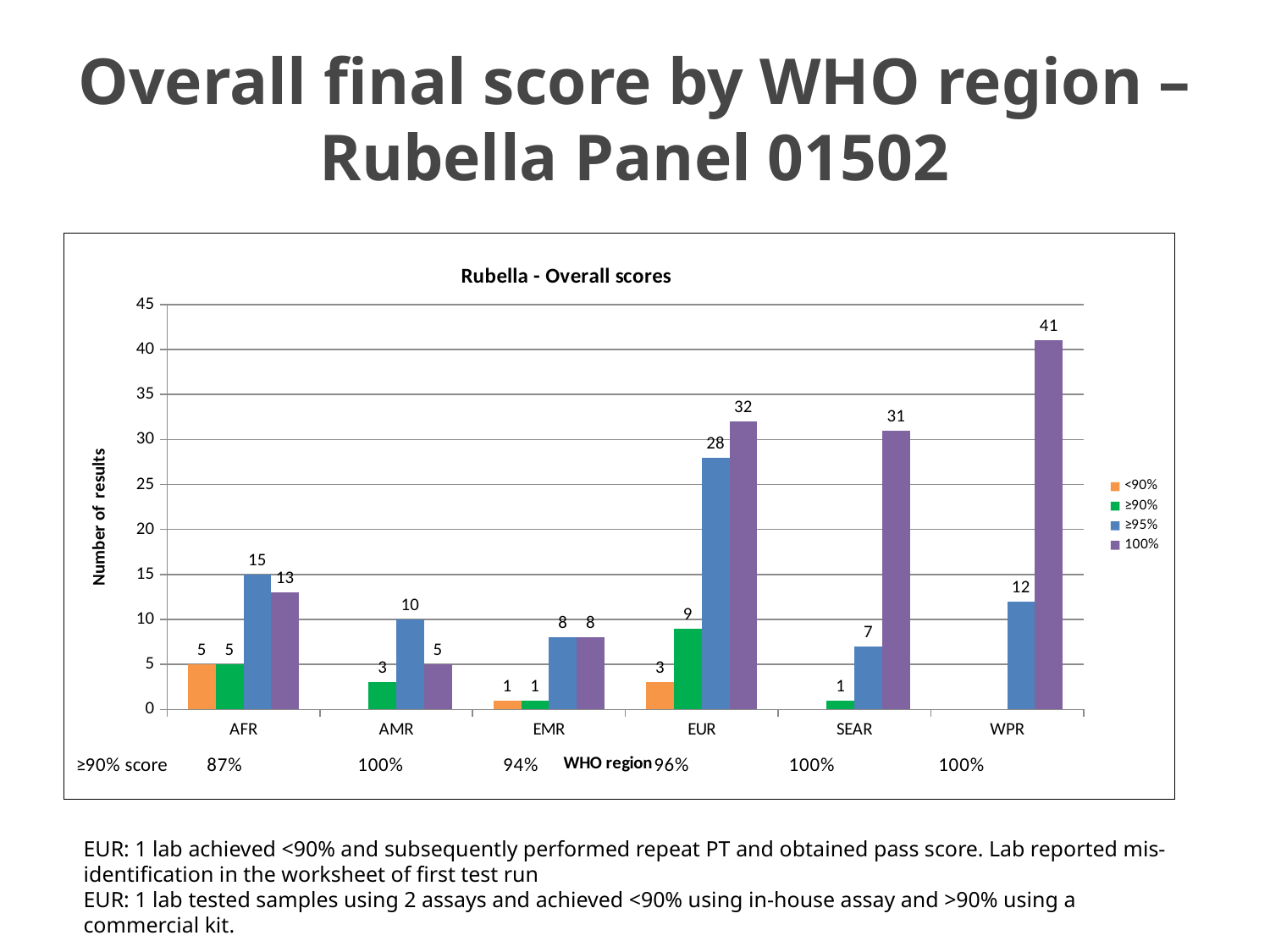
Is the value of the 100% series for EUR greater or less than 30? greater What type of chart is shown? Bar chart Which is larger for AFR: the ≥95% value or the 100% value? ≥95% How many WHO regions are shown on the x axis? 6 Which WHO region has the lowest value in the ≥95% series? SEAR What is the value of the ≥90% series for AMR? 3 How many series does the legend list? 4 What is the difference between the 100% and ≥95% values for SEAR? 24 Which WHO region has the highest value in the 100% series? WPR What is the title of the chart? Rubella - Overall scores What is the value of the ≥95% series for EUR? 28 What is the value of the 100% series for WPR? 41